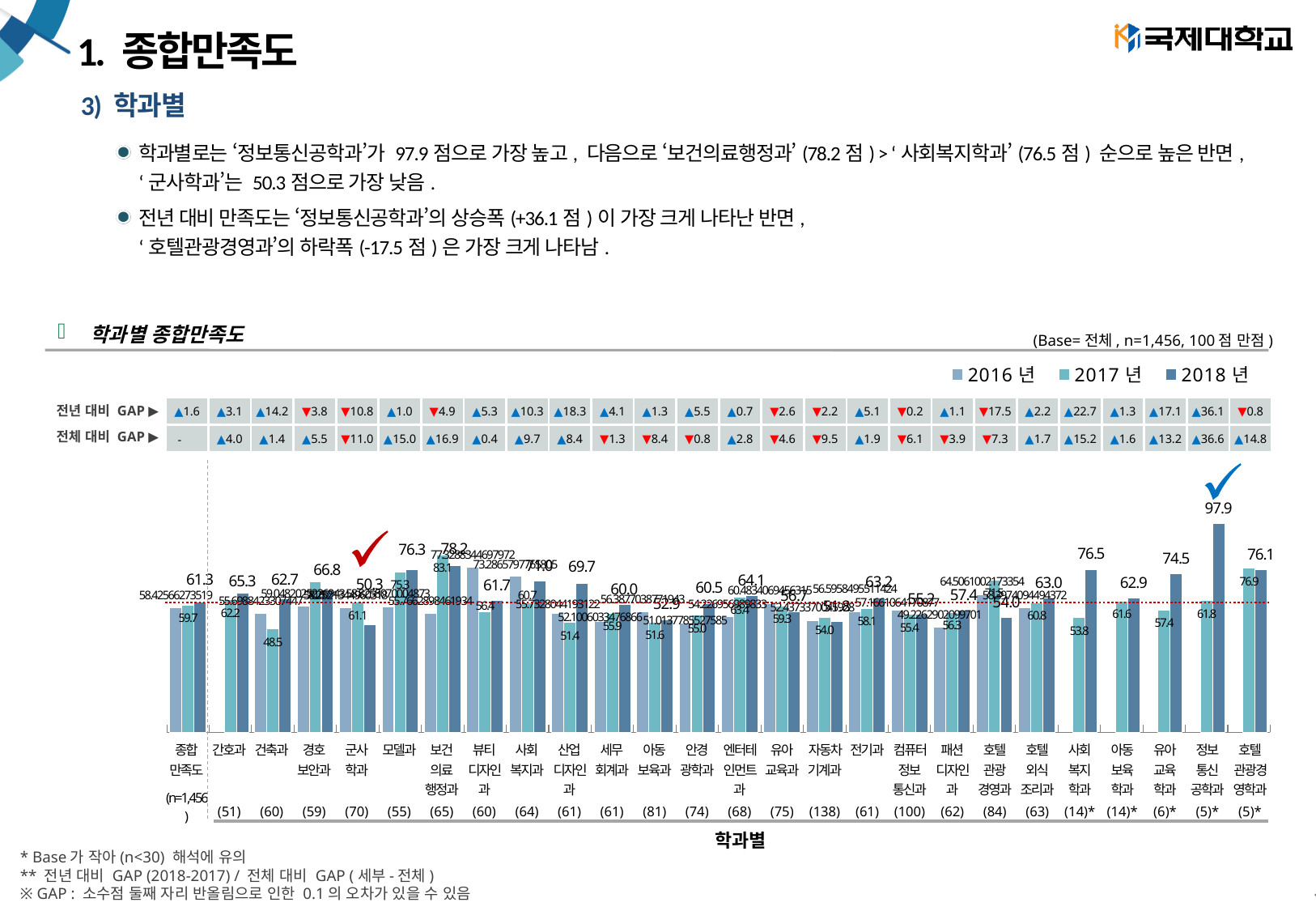
Which department has the lowest 2018 value? 군사학과 Which department has the highest 2018 value? 정보통신공학과 What type of chart is shown on the slide? bar chart What is the 2018 value for 군사학과? 50.3 What is the 2018 value for 보건의료행정과? 78.2 What is the 2017 value for 건축과? 48.5 What is the difference between the 2018 and 2017 values for 정보통신공학과? 36.1 Which legend entry is shown in the darkest blue? 2018 년 What is the 2018 value for 정보통신공학과? 97.9 What is the difference between the 2017 and 2018 values for 군사학과? 10.8 Which is larger for 사회복지학과: the 2017 value or the 2018 value? 2018 How many series does the legend list? 3